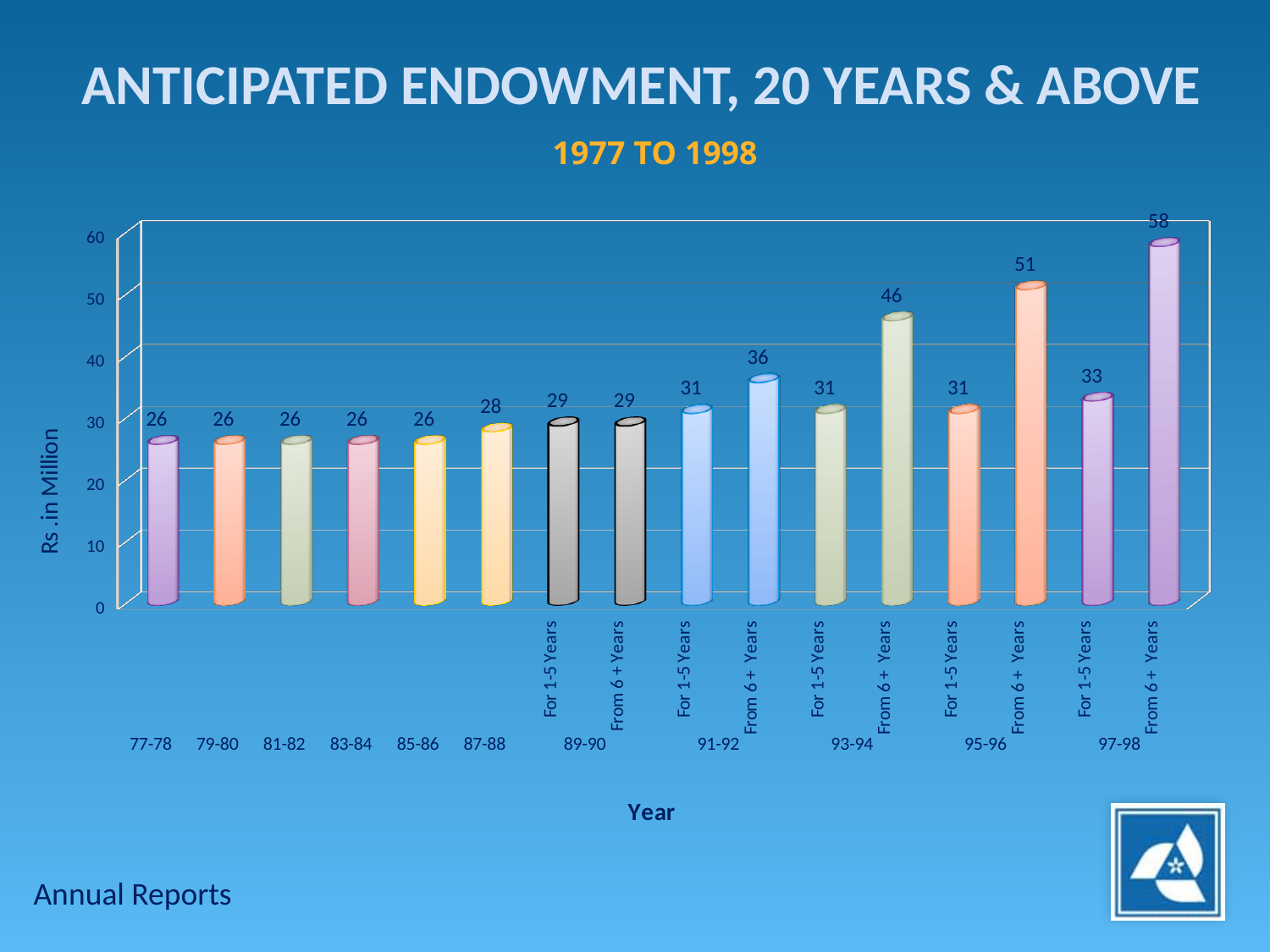
What kind of chart is shown? bar chart Which bar has the highest value? From 6+ Years, 97-98 Is the value for 'From 6+ Years' in 95-96 greater or less than 40? greater What is the value for 'For 1-5 Years' in 97-98? 33 How many bars are plotted on the chart? 16 What is the value for 77-78? 26 What is the value for 'From 6+ Years' in 93-94? 46 What is the value for 87-88? 28 What is the label of the vertical axis? Rs .in Million What is the highest value shown on the chart? 58 Which is larger: 'From 6+ Years' in 91-92 or 'From 6+ Years' in 93-94? From 6+ Years in 93-94 What is the difference between 'From 6+ Years' and 'For 1-5 Years' in 95-96? 20